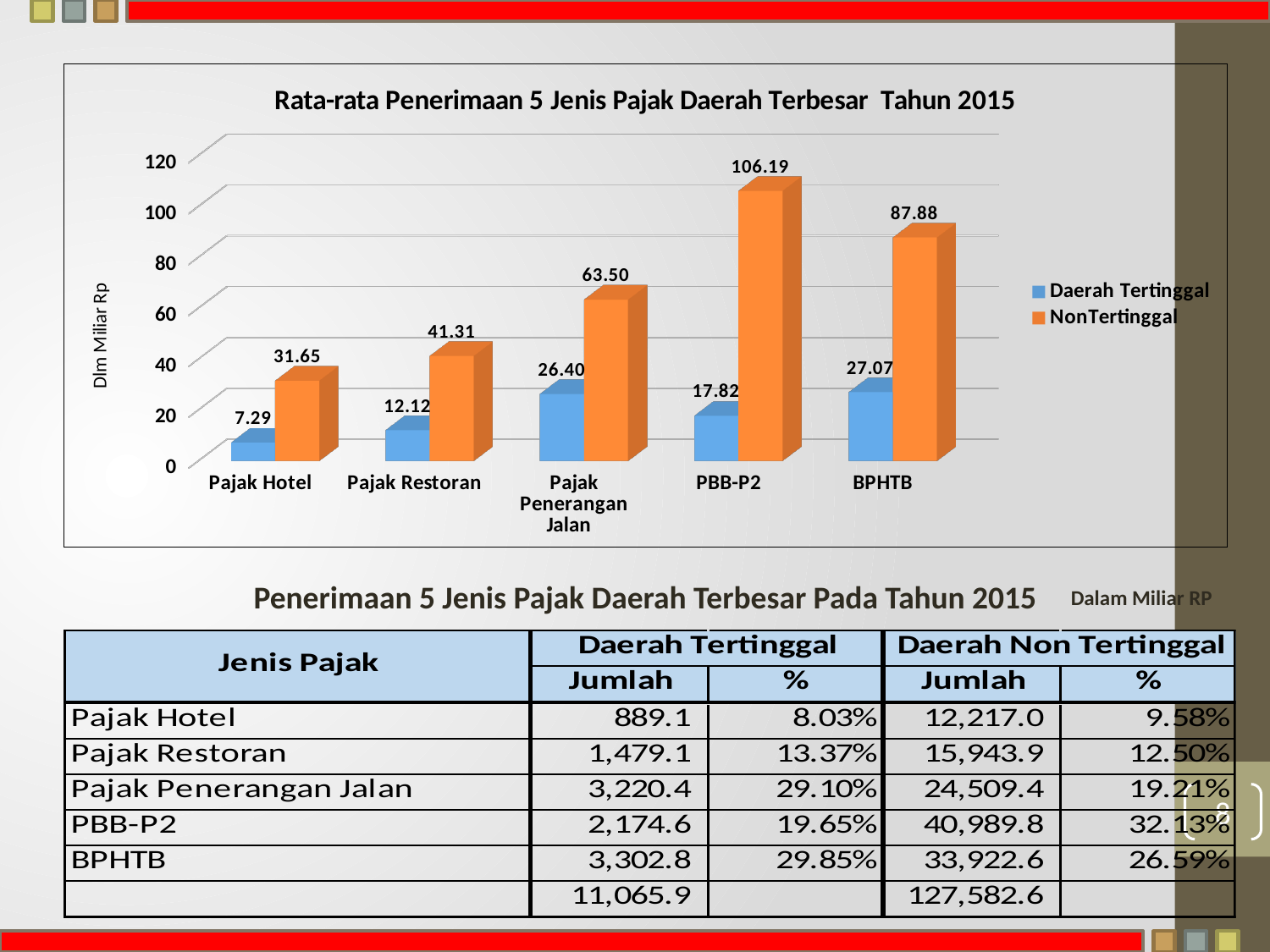
What kind of chart is shown on the slide? bar chart What is the difference between the NonTertinggal and Daerah Tertinggal values for BPHTB? 60.81 Which category has the lowest Daerah Tertinggal value? Pajak Hotel Which category has the highest NonTertinggal value? PBB-P2 What is the value for Daerah Tertinggal for Pajak Hotel? 7.29 What is the value for Daerah Tertinggal for Pajak Penerangan Jalan? 26.40 How many tax categories are shown on the x axis of the chart? 5 Is the NonTertinggal value for Pajak Restoran greater or less than 40? greater How many series does the chart legend list? 2 Which is larger for Daerah Tertinggal: Pajak Penerangan Jalan or PBB-P2? Pajak Penerangan Jalan What is the title of the chart? Rata-rata Penerimaan 5 Jenis Pajak Daerah Terbesar Tahun 2015 What is the value for NonTertinggal for PBB-P2? 106.19